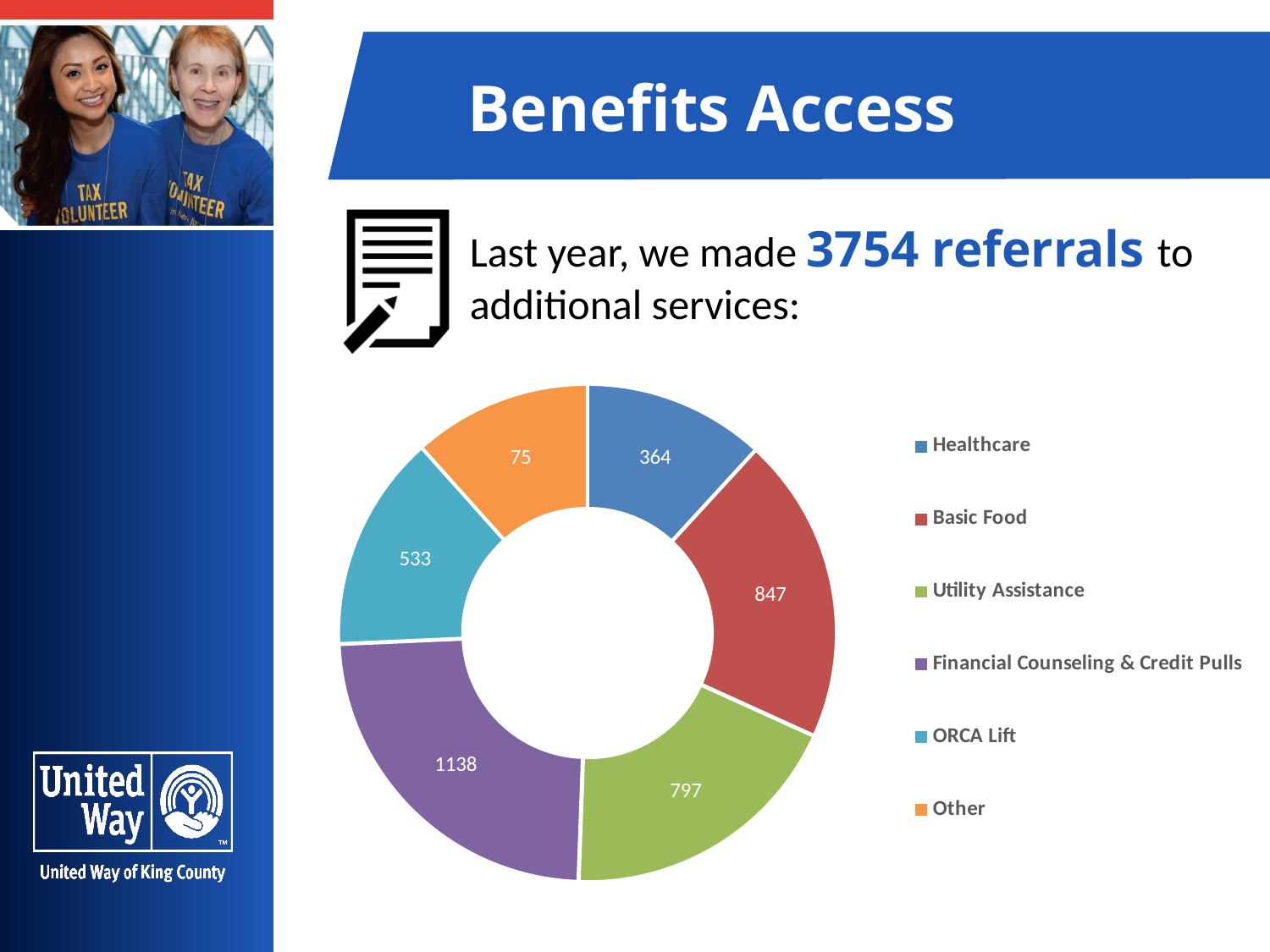
Which category has the largest number of referrals? Financial Counseling & Credit Pulls Which is larger, the value for Healthcare or the value for ORCA Lift? ORCA Lift How many more referrals were made for Financial Counseling & Credit Pulls than for Healthcare? 774 How many categories does the chart show? 6 What is the value shown for Financial Counseling & Credit Pulls? 1138 What is the total of all the values shown in the chart? 3754 How many referrals does the chart show for ORCA Lift? 533 Which category has the smallest number of referrals? Other What is the value for the Other category? 75 How many referrals were made for Basic Food? 847 What is the difference between the Basic Food and Utility Assistance values? 50 What kind of chart is shown on the slide? doughnut chart